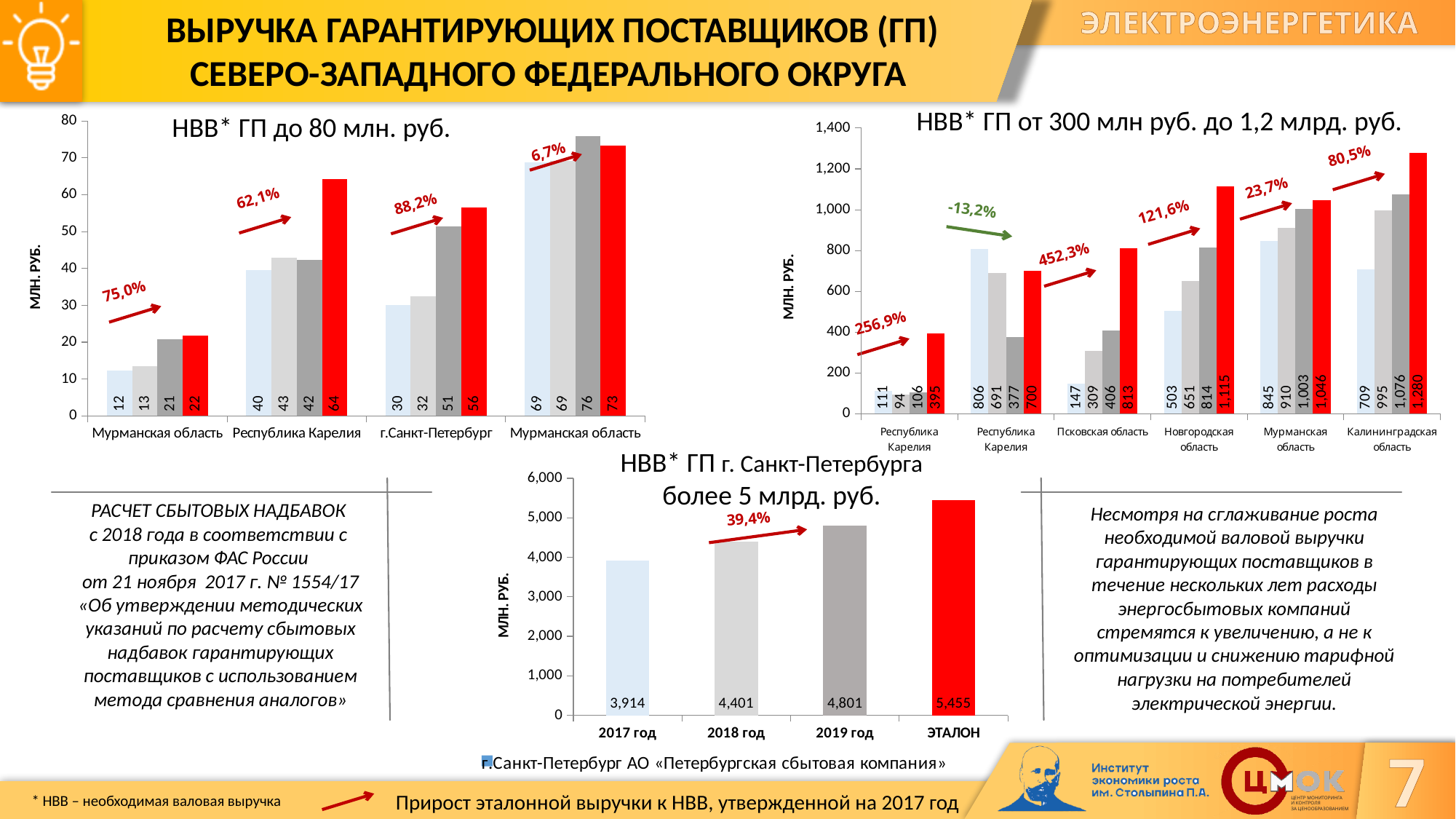
What kind of chart is the bottom chart 'НВВ* ГП г. Санкт-Петербурга более 5 млрд. руб.'? bar chart In the top-right chart 'НВВ* ГП от 300 млн руб. до 1,2 млрд. руб.', what is the value of the red bar for Калининградская область? 1,280 In the bottom chart 'НВВ* ГП г. Санкт-Петербурга более 5 млрд. руб.', how many bars are plotted? 4 In the bottom chart 'НВВ* ГП г. Санкт-Петербурга более 5 млрд. руб.', what is the value for 2017 год? 3,914 In the top-left chart 'НВВ* ГП до 80 млн. руб.', what growth percentage is shown above the first Мурманская область group? 75,0% In the bottom chart 'НВВ* ГП г. Санкт-Петербурга более 5 млрд. руб.', what is the difference between the ЭТАЛОН value and the 2019 год value? 654 In the bottom chart 'НВВ* ГП г. Санкт-Петербурга более 5 млрд. руб.', what is the value for ЭТАЛОН? 5,455 In the top-right chart 'НВВ* ГП от 300 млн руб. до 1,2 млрд. руб.', what is the value of the red bar for Псковская область? 813 In the bottom chart 'НВВ* ГП г. Санкт-Петербурга более 5 млрд. руб.', which category has the lowest value? 2017 год In the top-right chart 'НВВ* ГП от 300 млн руб. до 1,2 млрд. руб.', which group has the green arrow with a negative percentage, and what is that percentage? Республика Карелия, -13,2% In the bottom chart 'НВВ* ГП г. Санкт-Петербурга более 5 млрд. руб.', do the values rise or fall from 2017 год to ЭТАЛОН? rise In the top-left chart 'НВВ* ГП до 80 млн. руб.', what is the value of the red bar for Республика Карелия? 64